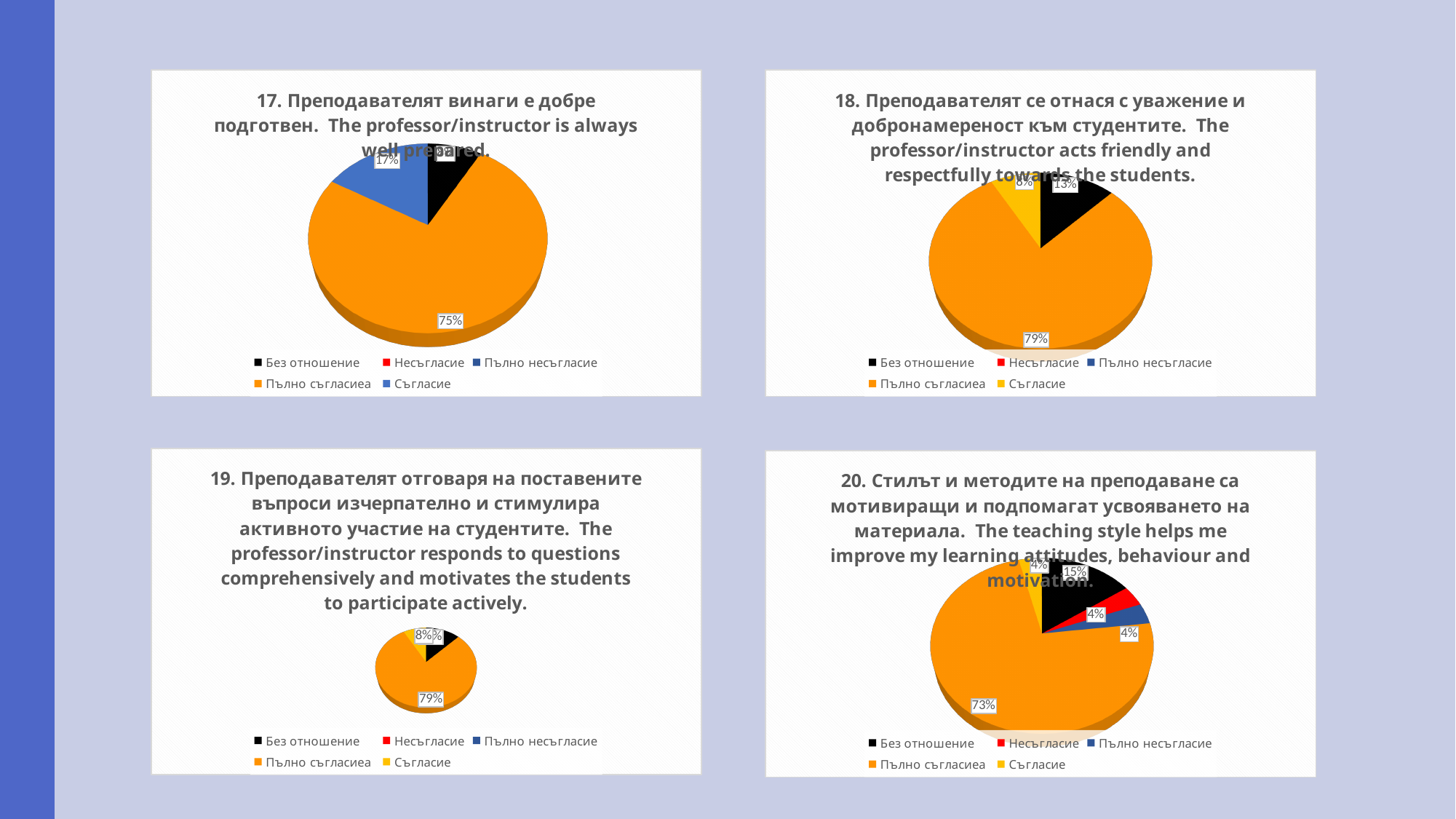
In the chart titled '17. The professor/instructor is always well prepared', what percentage is shown for Съгласие? 17% In the chart titled '18. The professor/instructor acts friendly and respectfully towards the students', what percentage is shown for Съгласие? 8% In the chart titled '18. The professor/instructor acts friendly and respectfully towards the students', what percentage is shown for Пълно съгласиеа? 79% In the chart titled '19. The professor/instructor responds to questions comprehensively and motivates the students to participate actively', what percentage is shown for Пълно съгласиеа? 79% In the chart titled '18. The professor/instructor acts friendly and respectfully towards the students', what is the difference in percentage points between Пълно съгласиеа and Без отношение? 66 What type of chart is used in the top-left chart on the slide? Pie chart In the chart titled '17. The professor/instructor is always well prepared', which category has the largest slice? Пълно съгласиеа How many entries does the legend of the top-left chart list? 5 In the chart titled '20. The teaching style helps me improve my learning attitudes, behaviour and motivation', what percentage is shown for Без отношение? 15% In the chart titled '17. The professor/instructor is always well prepared', what percentage is shown for Пълно съгласиеа? 75% In the chart titled '20. The teaching style helps me improve my learning attitudes, behaviour and motivation', what percentage is shown for Пълно съгласиеа? 73% In the chart titled '18. The professor/instructor acts friendly and respectfully towards the students', what percentage is shown for Без отношение? 13%